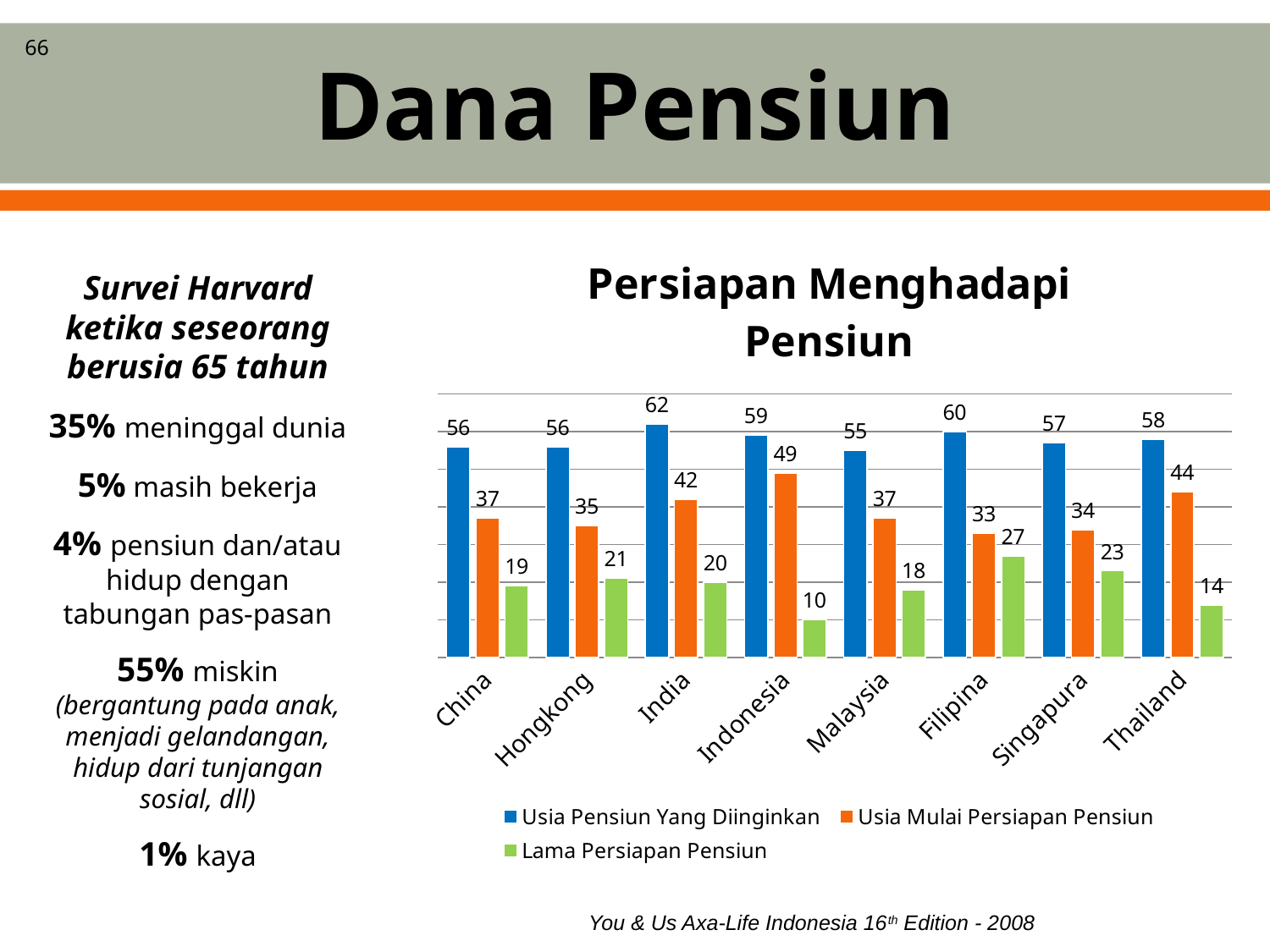
Which is larger: Usia Mulai Persiapan Pensiun for Thailand or for Singapura? Thailand How many countries are shown on the x axis? 8 Which country has the highest Usia Pensiun Yang Diinginkan? India What is the value of Usia Pensiun Yang Diinginkan for India? 62 Which series is shown in green? Lama Persiapan Pensiun How many series does the legend list? 3 What is the title of the chart? Persiapan Menghadapi Pensiun What kind of chart is shown? Bar chart What is the difference between Usia Pensiun Yang Diinginkan and Usia Mulai Persiapan Pensiun for Malaysia? 18 What is the value of Usia Mulai Persiapan Pensiun for Indonesia? 49 What is the value of Lama Persiapan Pensiun for Thailand? 14 Which country has the lowest Lama Persiapan Pensiun? Indonesia